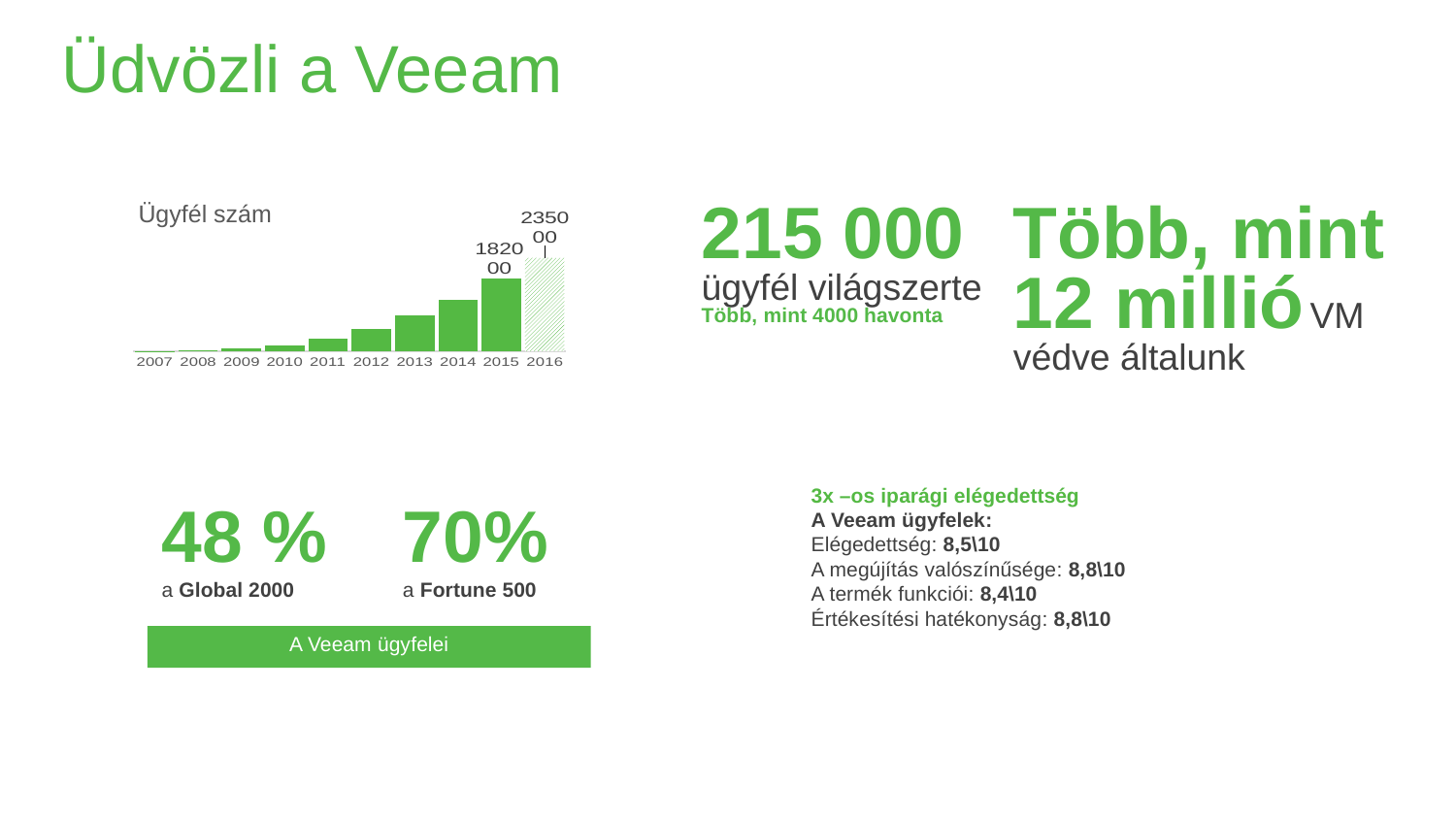
Which year has the highest bar in the "Ügyfél szám" chart? 2016 What is the value labelled on the 2015 bar in the "Ügyfél szám" chart? 182000 Which bar in the "Ügyfél szám" chart is drawn with a hatched pattern instead of solid green? 2016 Which year has the lowest bar in the "Ügyfél szám" chart? 2007 How many years are shown on the x axis of the "Ügyfél szám" chart? 10 In the "Ügyfél szám" chart, which bar is taller, 2014 or 2015? 2015 What is the first year shown on the x axis of the "Ügyfél szám" chart? 2007 What is the value labelled on the 2016 bar in the "Ügyfél szám" chart? 235000 What kind of chart is shown under the heading "Ügyfél szám"? bar chart In the "Ügyfél szám" chart, do the bars rise or fall from 2007 to 2016? rise In the "Ügyfél szám" chart, what is the difference between the 2016 value and the 2015 value? 53000